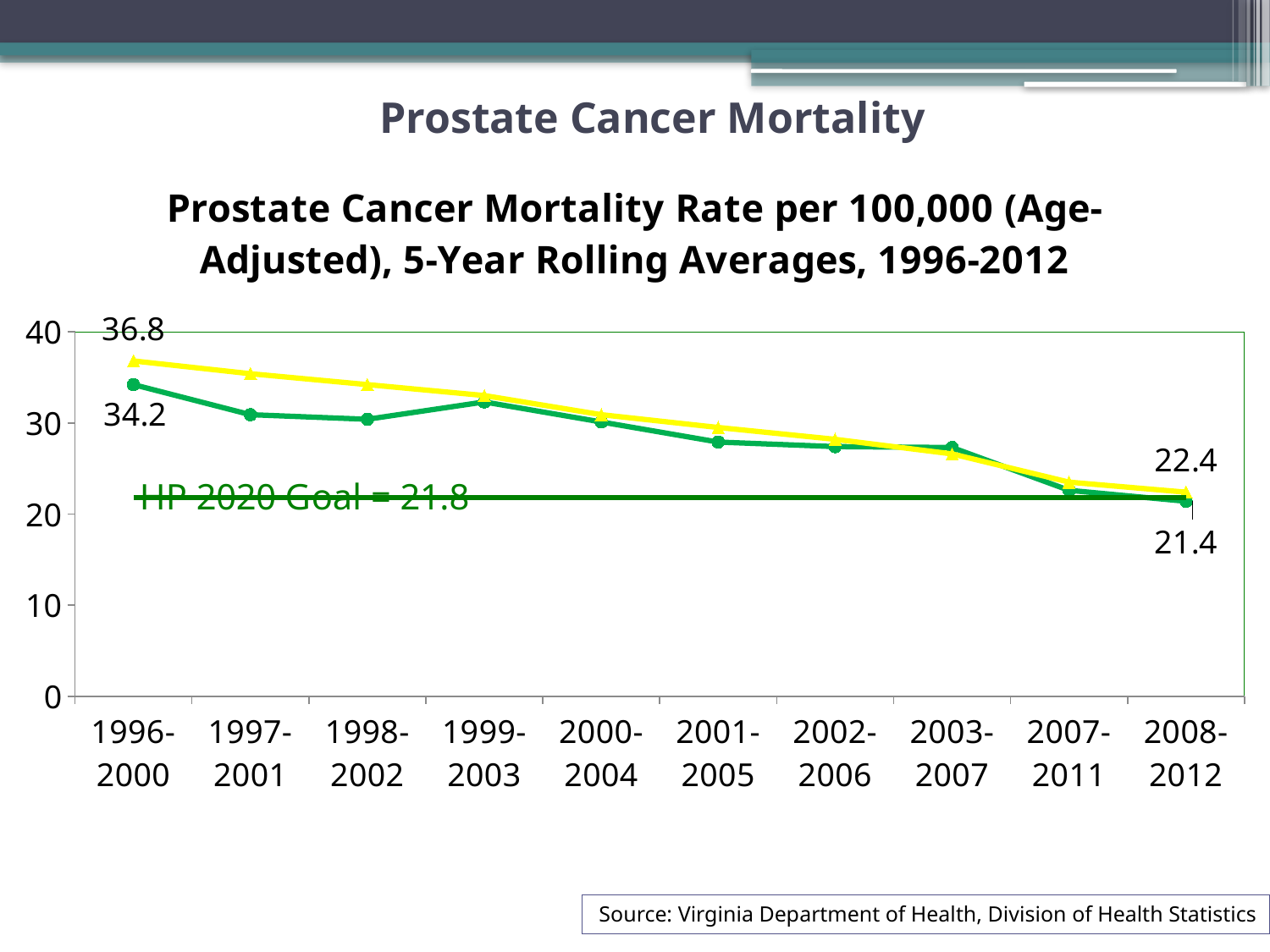
What is the value of the green line for 2008-2012? 21.4 What is the difference between the yellow and green line values for 1996-2000? 2.6 What is the HP 2020 Goal value marked on the chart? 21.8 Do the values of the lines rise or fall from 1996-2000 to 2008-2012? fall By how much did the yellow line fall from 1996-2000 to 2008-2012? 14.4 What is the value of the yellow line for 2008-2012? 22.4 What is the value of the yellow line for 1996-2000? 36.8 What kind of chart is shown on the slide? line chart How many time periods are shown on the x axis of the chart? 10 By how much did the green line fall from 1996-2000 to 2008-2012? 12.8 What is the value of the green line for 1996-2000? 34.2 Is the value of the green line for 2001-2005 greater or less than 30? less